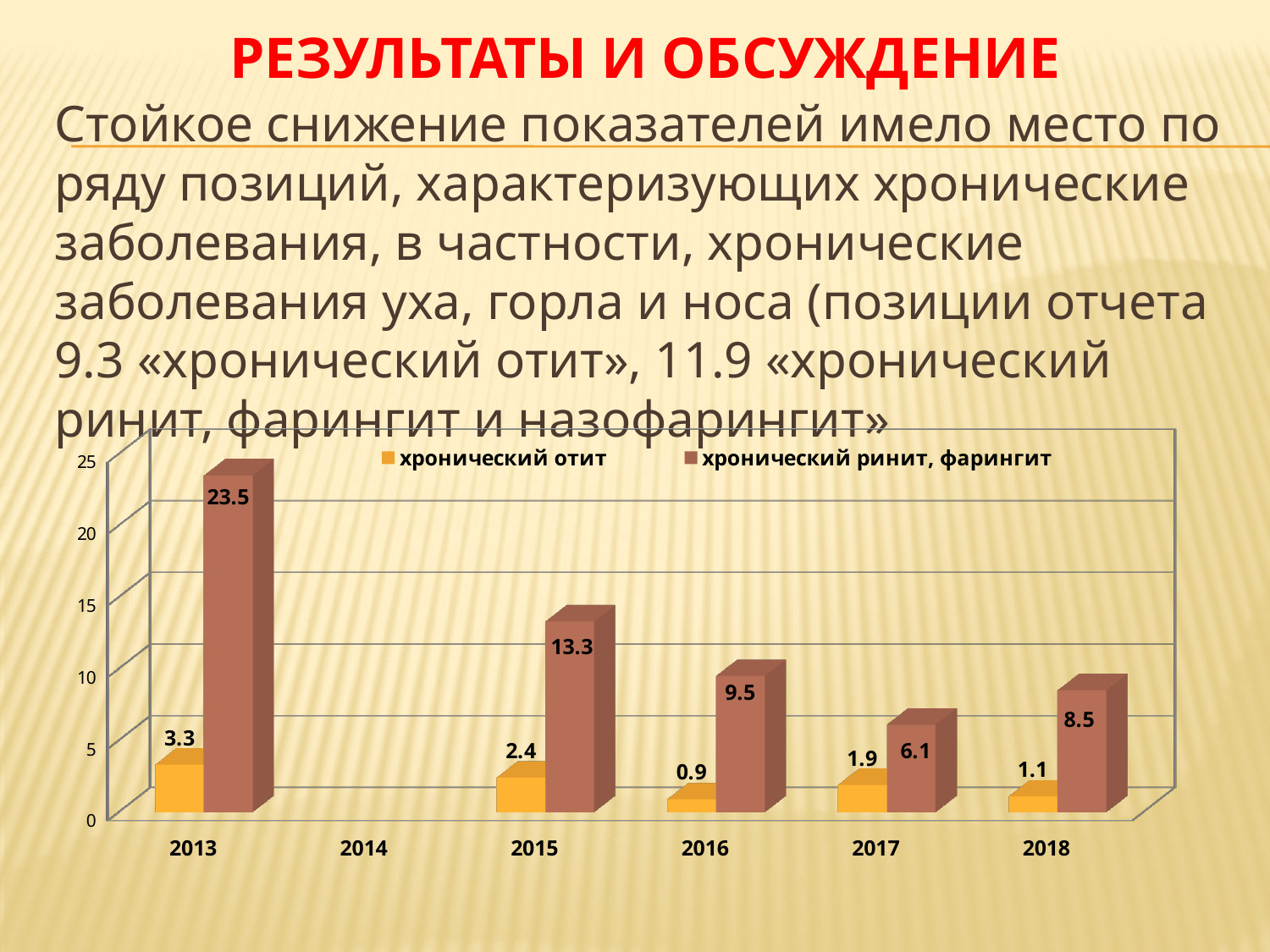
What is the value for хронический отит in 2015? 2.4 What is the value for хронический отит in 2018? 1.1 What is the value for хронический ринит, фарингит in 2017? 6.1 How many years are labelled on the x axis? 6 What kind of chart is shown on the slide? bar chart Which is larger: the хронический отит value for 2017 or for 2018? 2017 In which year is the value for хронический ринит, фарингит highest? 2013 Is the value for хронический ринит, фарингит in 2016 greater or less than 10? less What is the value for хронический ринит, фарингит in 2013? 23.5 In which year is the value for хронический отит lowest? 2016 How many series does the legend list? 2 What is the difference between the хронический ринит, фарингит values for 2013 and 2015? 10.2